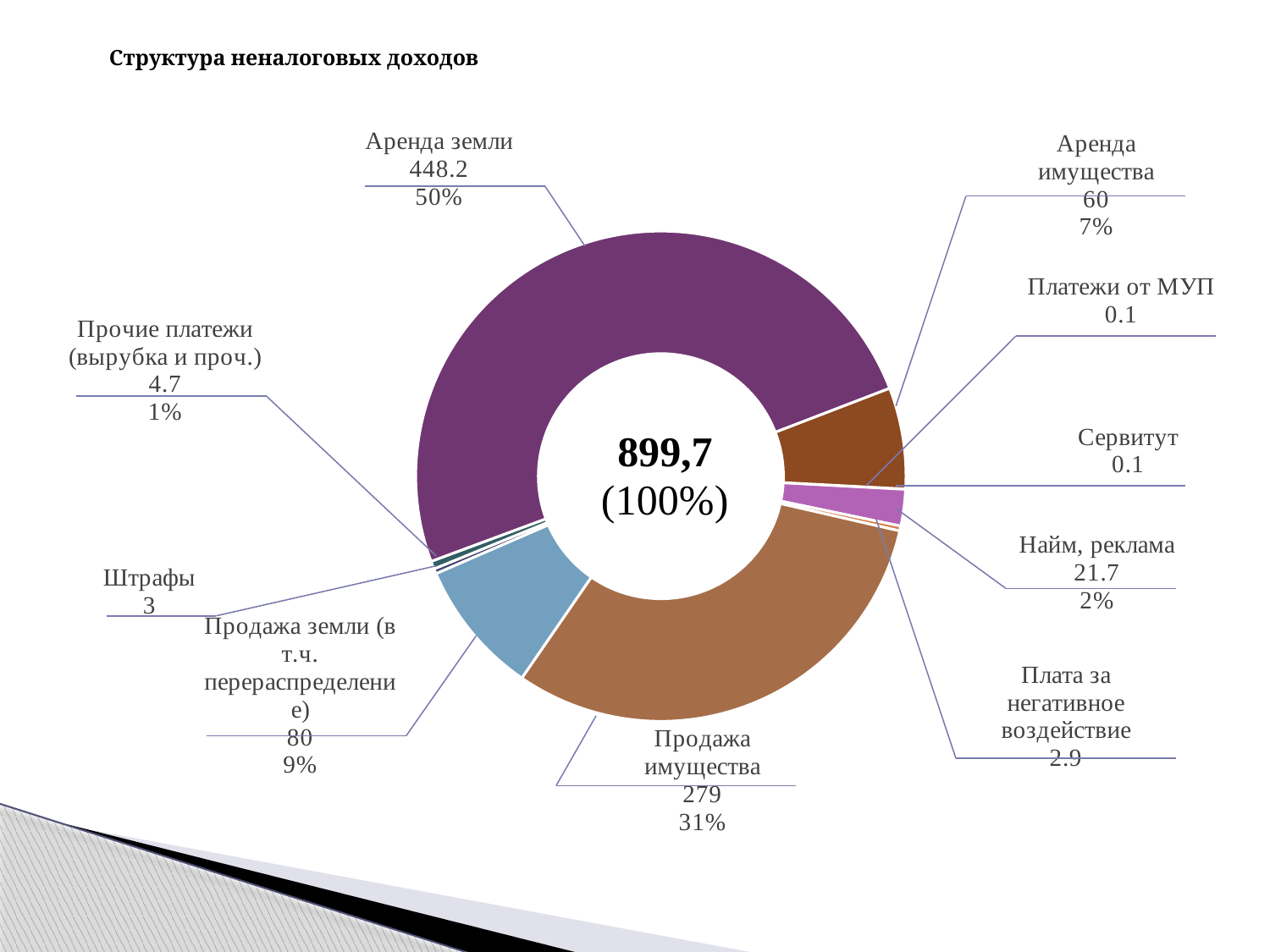
What is the value for Плата за негативное воздействие? 2.9 What is the difference between the values for Аренда земли and Продажа имущества? 169.2 What is the value for Найм, реклама? 21.7 What share of the chart does Аренда имущества represent? 7% What is the value for Аренда земли? 448.2 What total value is shown in the centre of the chart? 899,7 What is the value for Продажа имущества? 279 What share of the chart does Продажа имущества represent? 31% Which category has the largest share of the chart? Аренда земли How many categories are shown in the chart? 10 Which is larger, the value for Аренда имущества or the value for Продажа земли (в т.ч. перераспределение)? Продажа земли (в т.ч. перераспределение) What kind of chart is shown on the slide? Doughnut chart